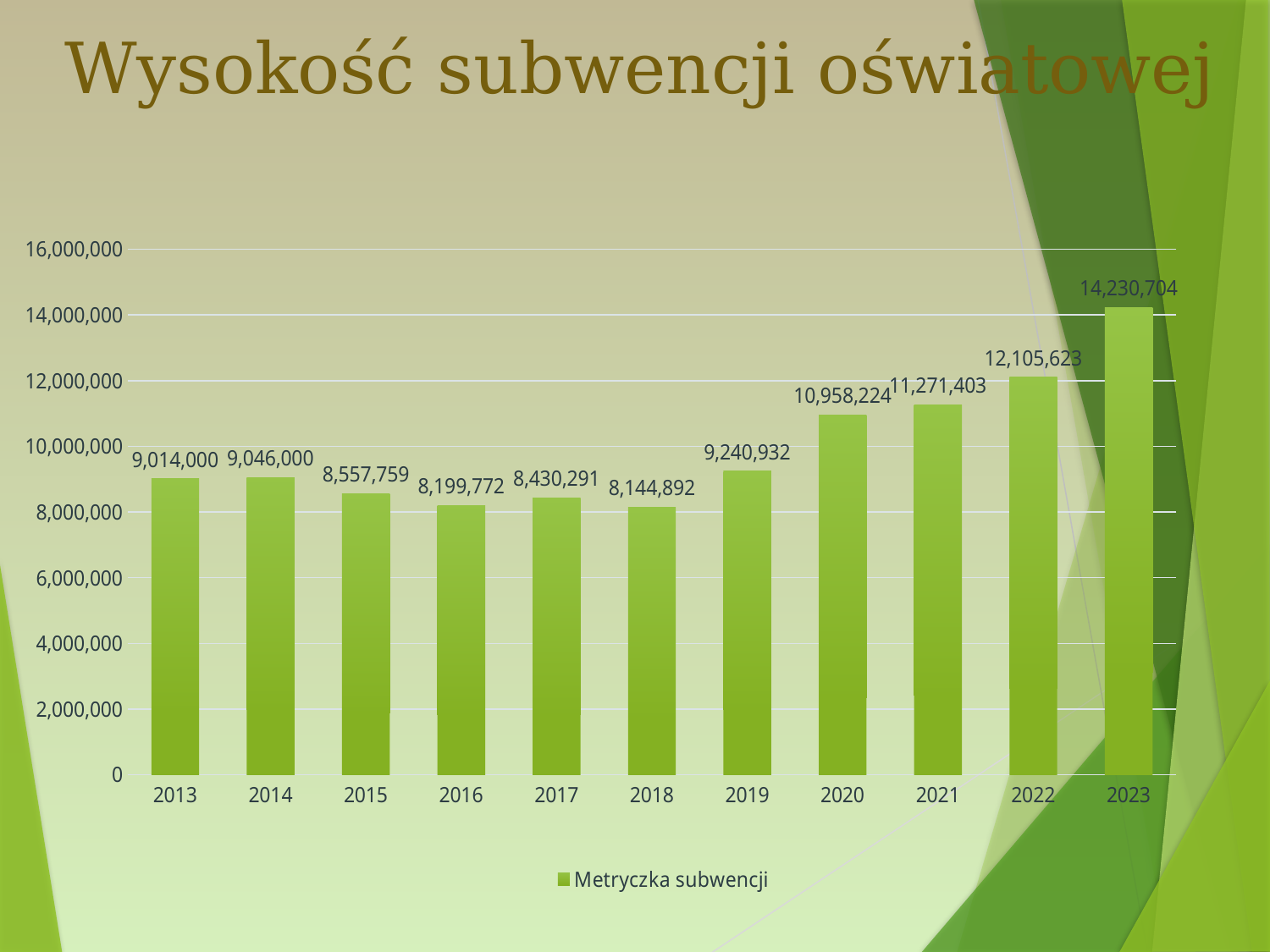
What is the value for 2018? 8,144,892 What type of chart is shown on the slide? bar chart What is the difference between the values for 2023 and 2022? 2,125,081 What is the legend entry for the series? Metryczka subwencji How many years are shown on the x axis? 11 How many series does the legend list? 1 Which is larger, the value for 2017 or the value for 2016? 2017 What is the value for 2023? 14,230,704 Which year has the lowest value? 2018 What is the difference between the values for 2014 and 2013? 32,000 What is the value for 2020? 10,958,224 Which year has the highest value? 2023